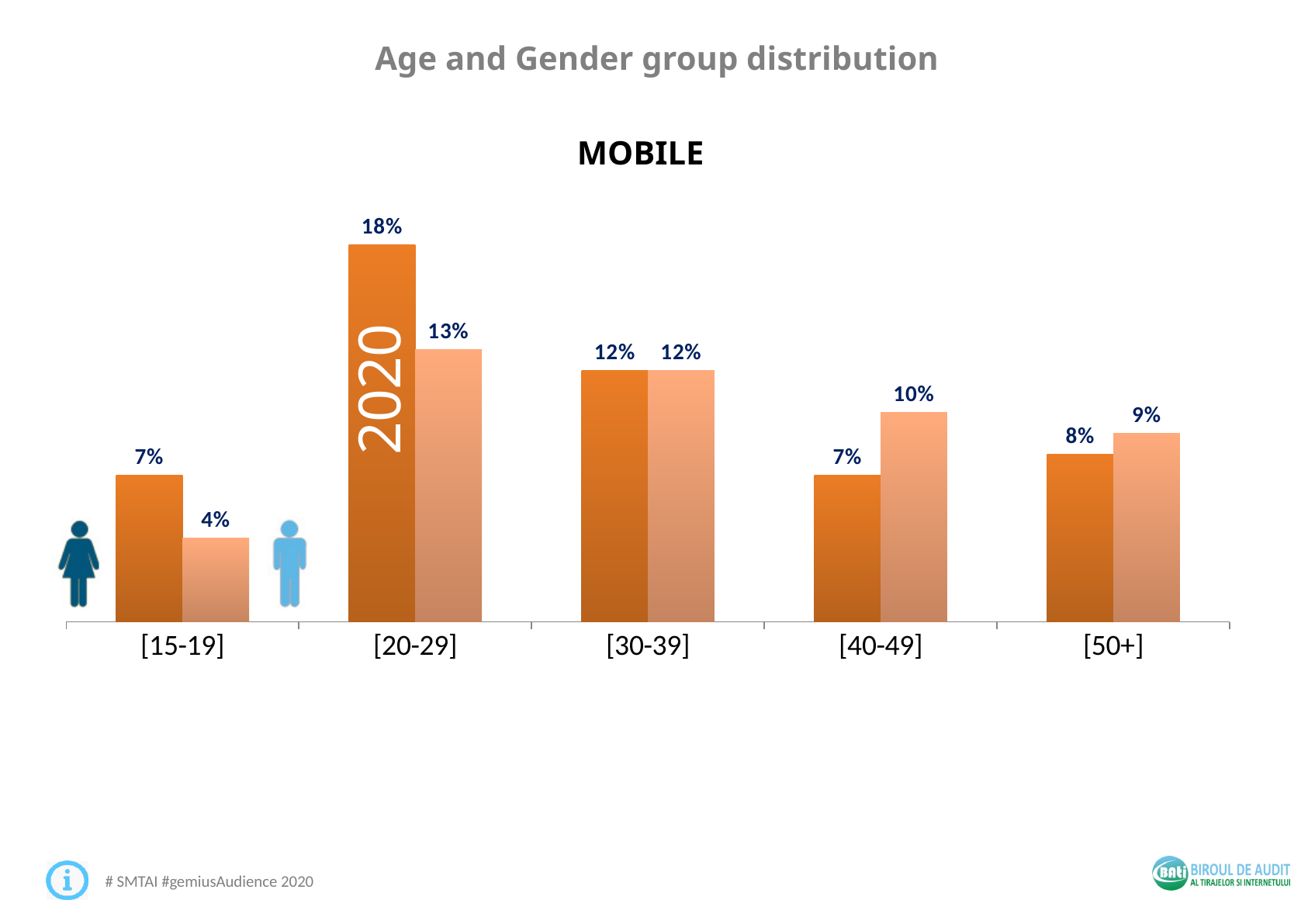
What is the difference between the dark orange and light orange bars for the [20-29] age group? 5% What is the value of the light orange bar for the [15-19] age group? 4% What kind of chart is shown on the slide? bar chart What is the value of the light orange bar for the [40-49] age group? 10% What is the value of the dark orange bar for the [50+] age group? 8% What year is written on the tallest bar of the chart? 2020 Which age group has the highest dark orange bar? [20-29] Which age group has the lowest light orange bar? [15-19] What is the value of the dark orange bar for the [20-29] age group? 18% How many age groups are shown on the x axis? 5 For the [40-49] age group, which bar is larger, the dark orange or the light orange? light orange How many series of bars are plotted for each age group? 2